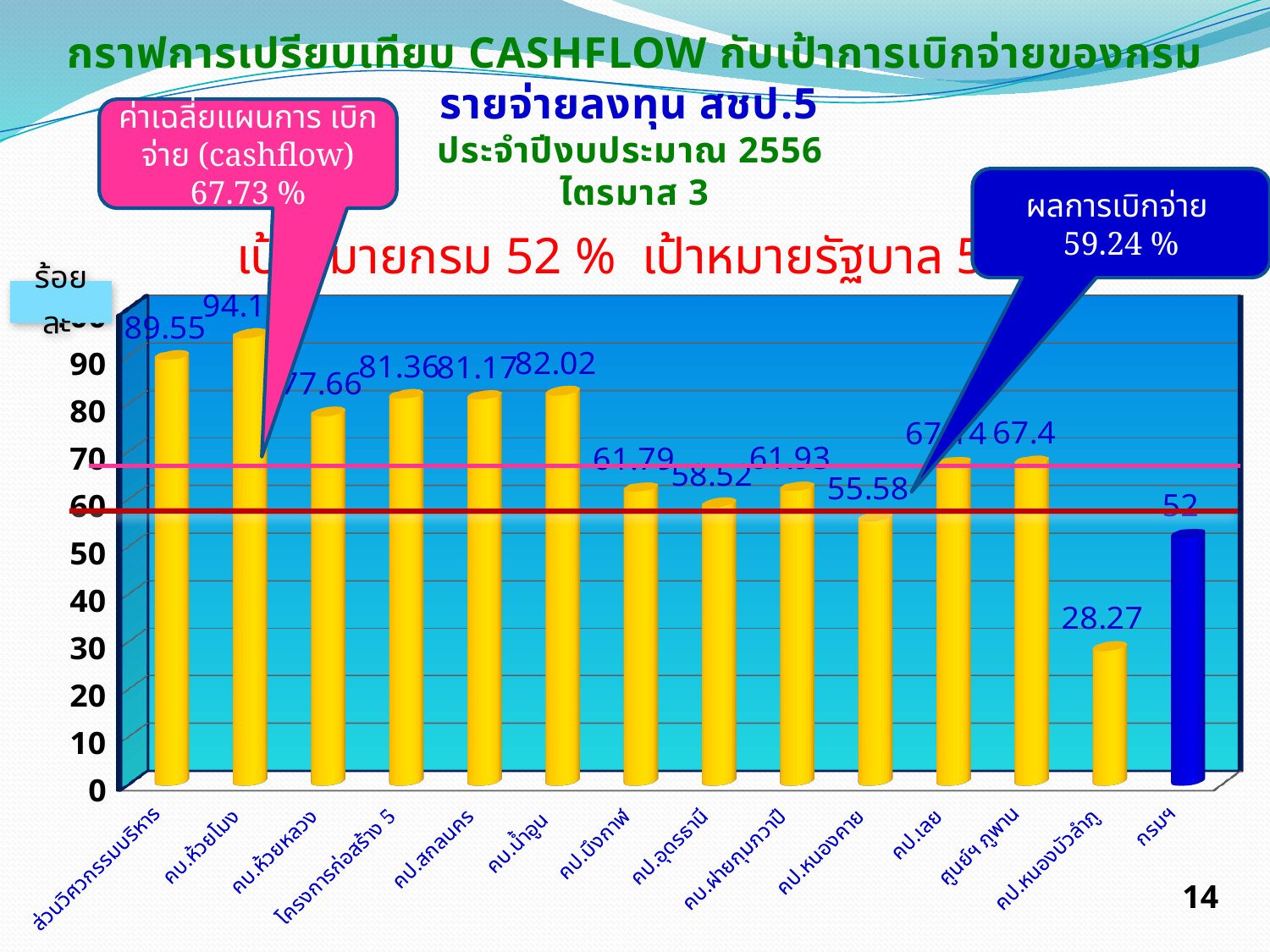
What is the value shown for คบ.ห้วยโมง? 94.1 Which category has the lowest value? คป.หนองบัวลำภู What percentage is given in the blue callout labelled ผลการเบิกจ่าย? 59.24 % What kind of chart is shown on the slide? bar chart What is the value shown for คบ.ห้วยหลวง? 77.66 Is the value for คป.หนองคาย greater or less than 60? less What is the value shown for กรมฯ? 52 What is the difference between the values for คบ.ห้วยโมง and กรมฯ? 42.1 What is the value shown for คป.หนองบัวลำภู? 28.27 Which category has the highest value? คบ.ห้วยโมง Which is larger, the value for คป.บึงกาฬ or the value for คป.อุดรธานี? คป.บึงกาฬ How many categories are shown on the x axis? 14